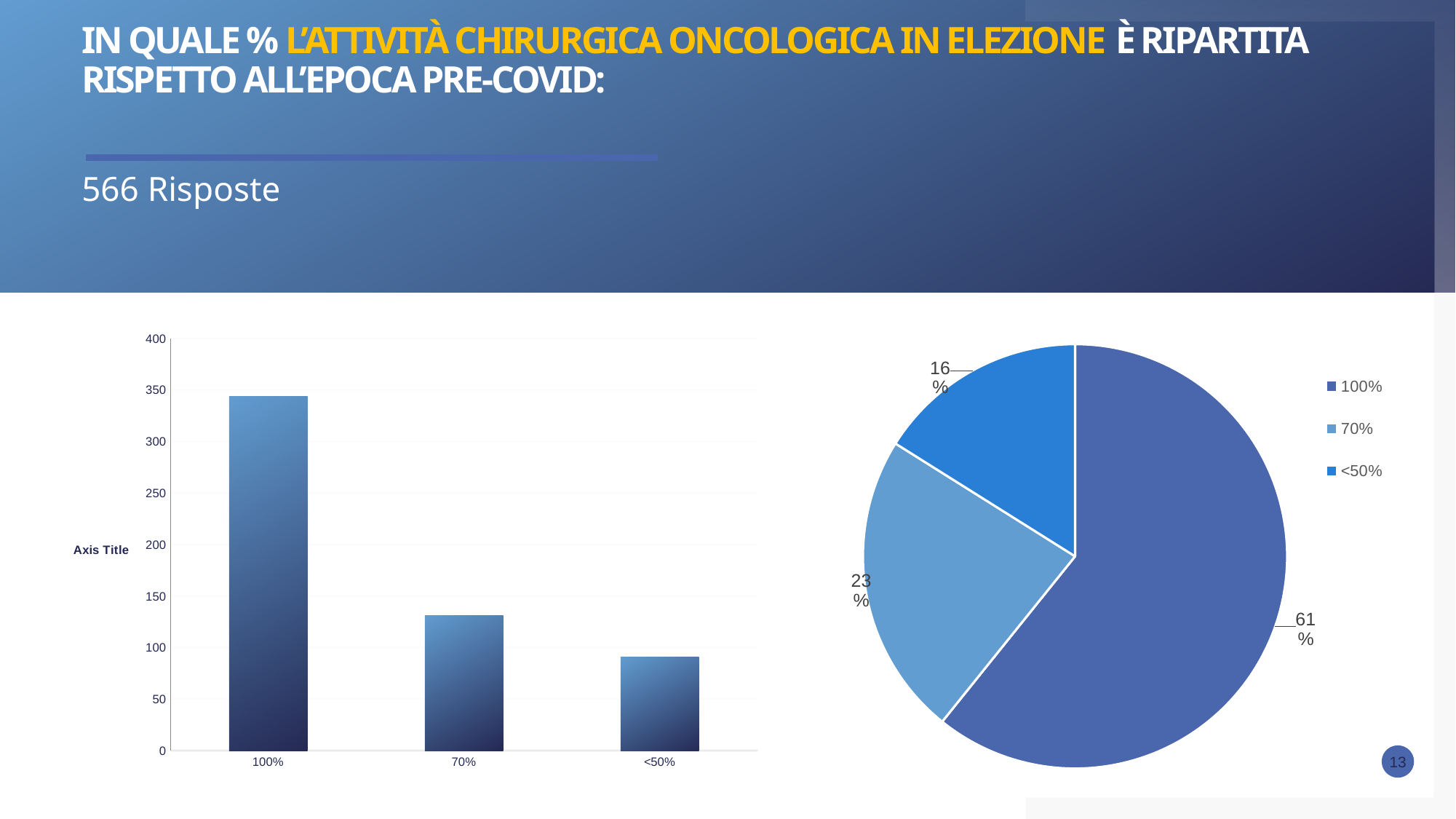
In the bar chart on the left, is the value for 100% greater or less than 300? greater In the pie chart on the right, how many entries does the legend list? 3 In the bar chart on the left, is the value for <50% greater or less than 100? less In the bar chart on the left, is the value for 70% greater or less than 150? less What kind of chart is on the left side of the slide? bar chart In the bar chart on the left, how many categories are shown on the x axis? 3 In the bar chart on the left, which category has the highest bar? 100% In the pie chart on the right, what share of the pie does the 100% slice represent? 61% In the bar chart on the left, which category has the lowest bar? <50% In the pie chart on the right, what share of the pie does the <50% slice represent? 16% What kind of chart is on the right side of the slide? pie chart In the bar chart on the left, do the bar values rise or fall from left to right along the x axis? fall